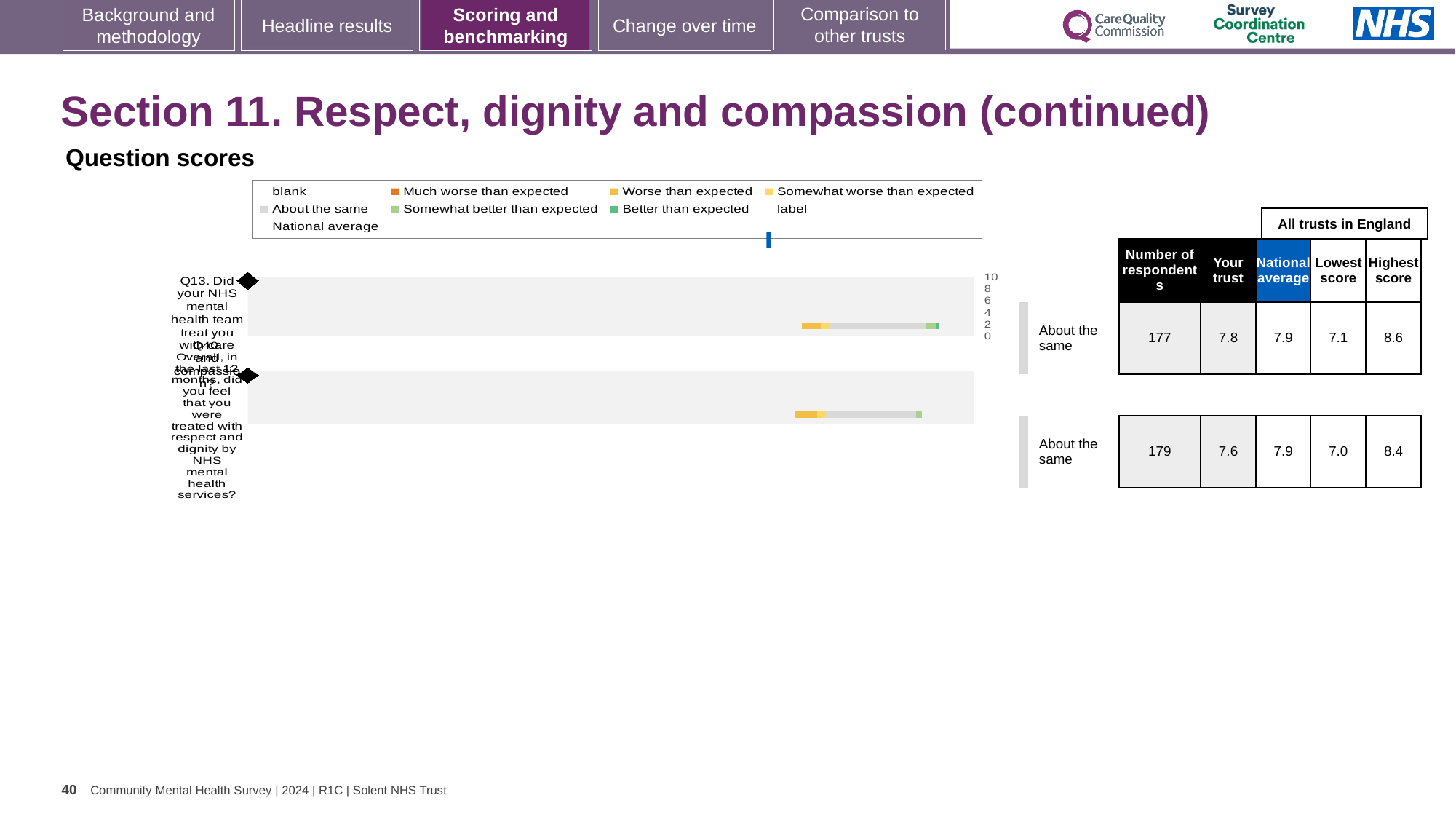
How many respondents are shown for Q14? 179 What benchmark category is shown next to the bar for Q13? About the same Which question has the higher 'Your trust' score, Q13 or Q14? Q13 What is the 'Your trust' score shown for Q13 (treated with care and compassion)? 7.8 By how much is the national average higher than the 'Your trust' score for Q14? 0.3 What is the lowest score across all trusts in England shown for Q14? 7.0 What is the difference between the highest score and the lowest score shown for Q13? 1.5 What kind of chart is used to show the question scores? Bar chart How many survey questions are plotted in the chart? 2 What is the 'Your trust' score shown for Q14 (treated with respect and dignity)? 7.6 What is the national average score shown for Q13? 7.9 What is the highest score across all trusts in England shown for Q13? 8.6